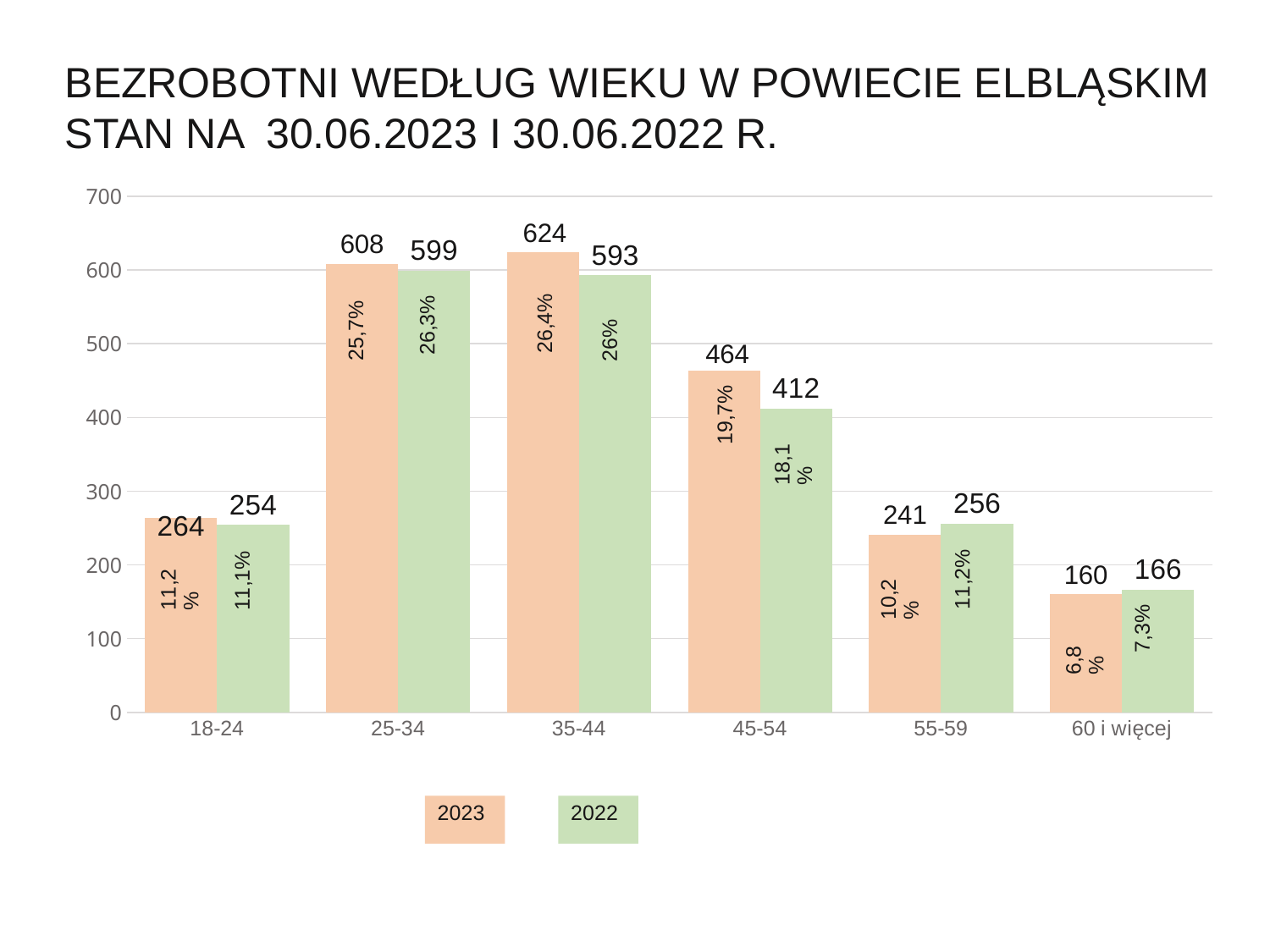
Which is larger for the 55-59 age group, the 2023 value or the 2022 value? 2022 Which age group has the lowest value in 2022? 60 i więcej What is the value for the 45-54 age group in 2022? 412 How many series does the legend list? 2 Which age group has the highest value in 2023? 35-44 Which colour represents the 2022 series in the legend? green How many age groups are shown on the x axis? 6 What percentage share is shown inside the 2022 bar for the 25-34 age group? 26,3% Is the 2023 value for the 18-24 age group greater or less than 300? less What is the value for the 35-44 age group in 2023? 624 What is the difference between the 2023 and 2022 values for the 45-54 age group? 52 What kind of chart is shown on the slide? bar chart